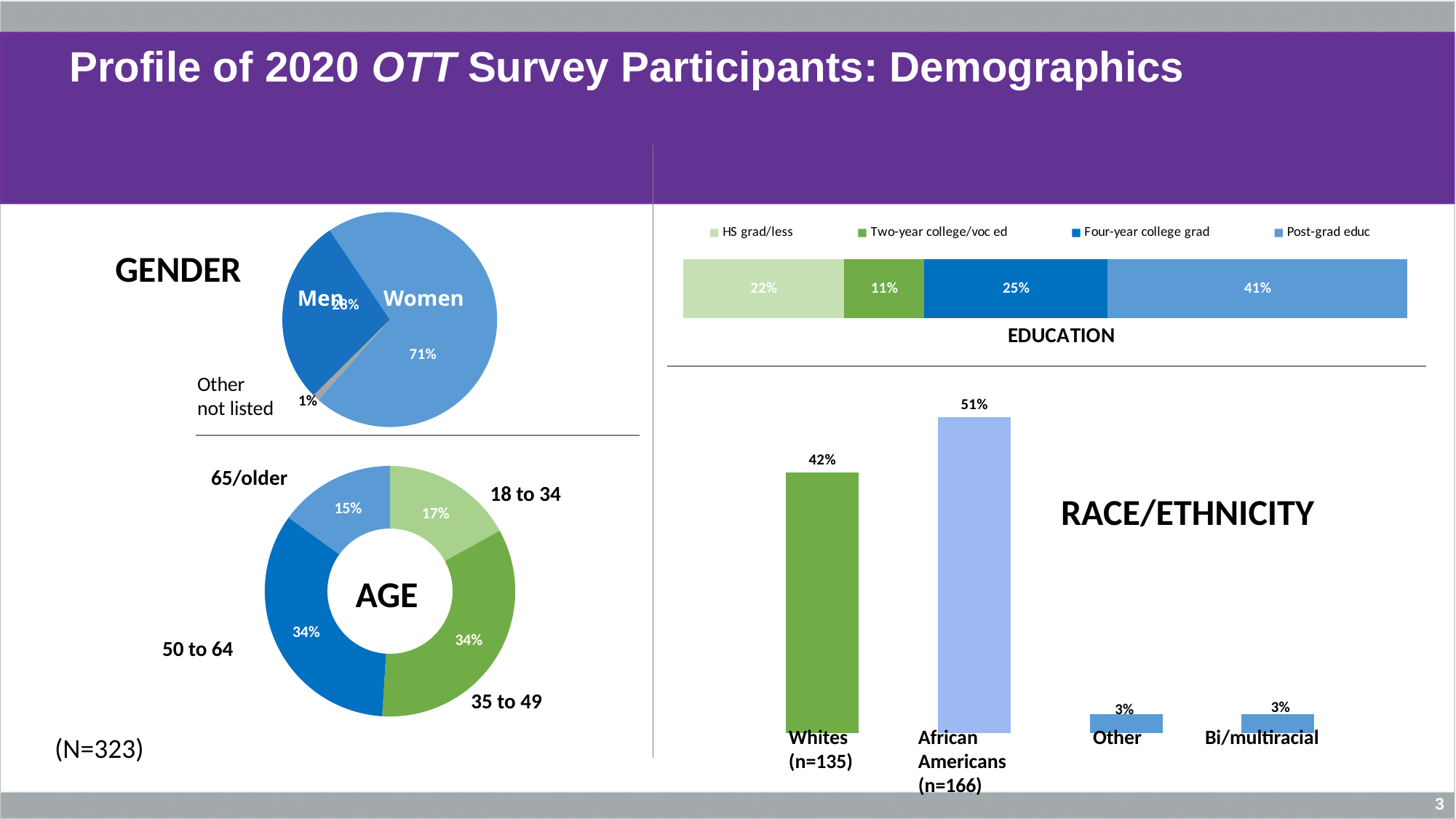
In the Age donut chart, what is the difference between the 50 to 64 share and the 65/older share? 19% In the Race/Ethnicity chart, which group has the highest percentage? African Americans In the Education stacked bar, what percentage of participants have post-grad education? 41% In the Education stacked bar, which education level has the smallest share? Two-year college/voc ed What kind of chart is the Race/Ethnicity chart? Bar chart In the Gender pie chart, what percentage of participants are women? 71% In the Age donut chart, what percentage of participants are 18 to 34? 17% In the Gender pie chart, what percentage of participants chose 'Other not listed'? 1% In the Race/Ethnicity chart, what percentage of participants are African Americans? 51% How many education categories does the legend of the Education chart list? 4 How many age groups are shown in the Age donut chart? 4 In the Age donut chart, which age group has the smallest share? 65/older